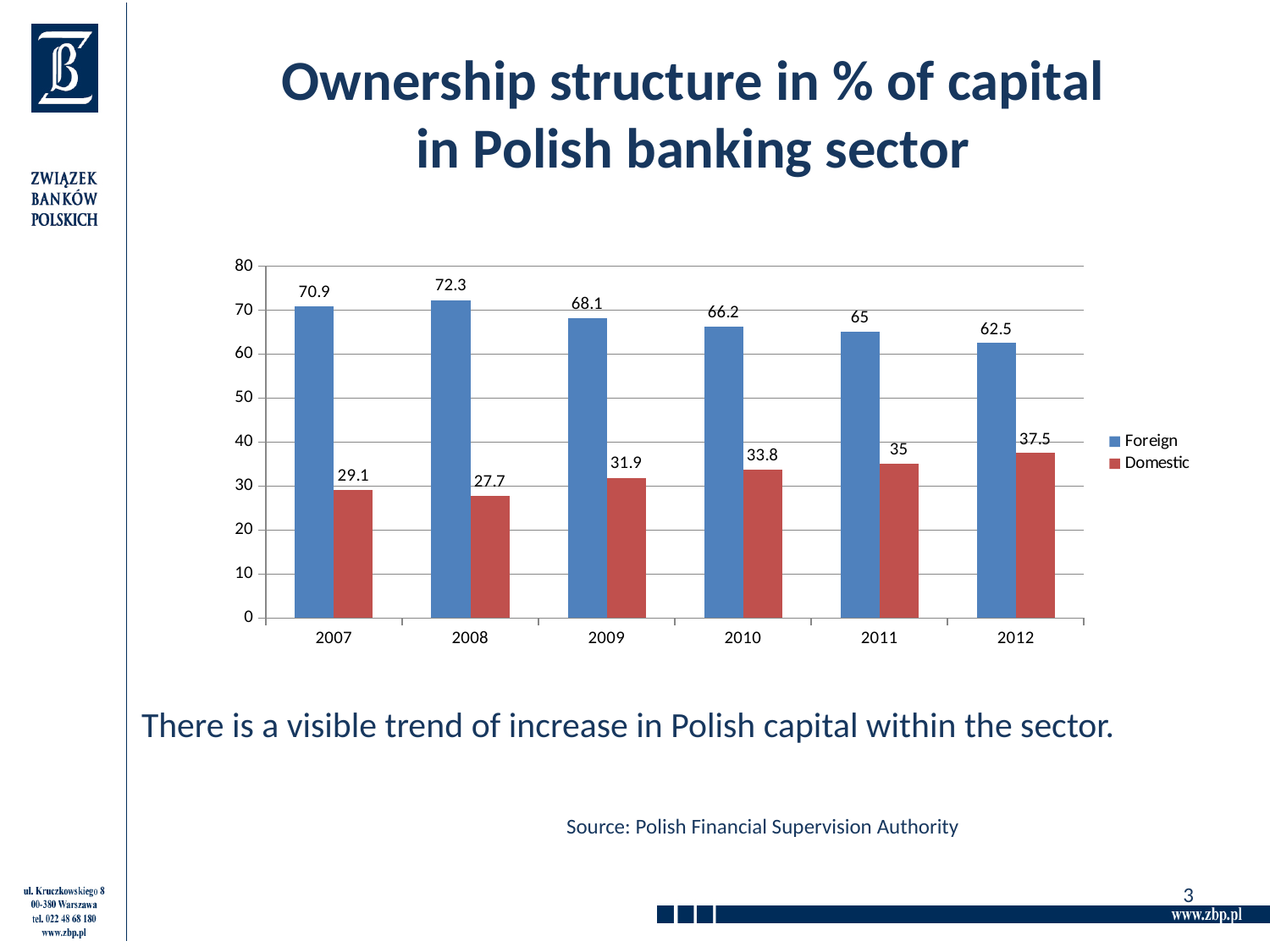
Does the Domestic value rise or fall from 2008 to 2012? rise What is the Domestic value for 2012? 37.5 In which year is the Foreign value highest? 2008 How many series does the legend list? 2 What kind of chart is shown on the slide? bar chart Which is larger, the Domestic value for 2010 or the Domestic value for 2011? 2011 How many years are shown on the x axis? 6 What is the difference between the Foreign and Domestic values in 2012? 25 What is the Domestic value for 2009? 31.9 What is the Foreign value for 2007? 70.9 Is the Foreign value for 2011 greater or less than 60? greater In which year is the Domestic value lowest? 2008